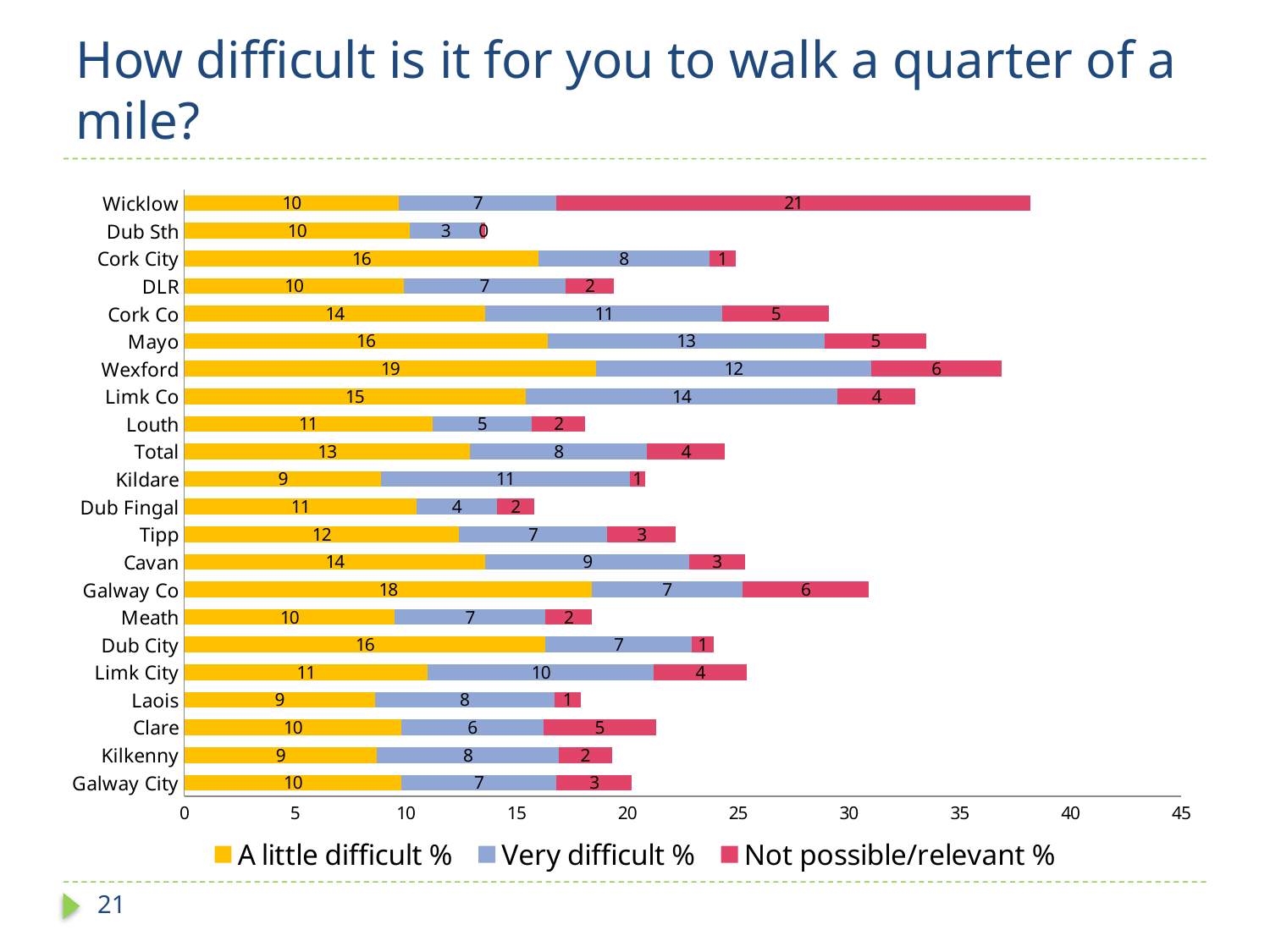
What is the total of the stacked bar for Wicklow? 38 What is the total of the stacked bar for Total? 25 How many categories are shown on the chart? 22 What is the 'Not possible/relevant %' value for Wicklow? 21 Which is larger, the 'A little difficult %' value for Galway Co or for Cork City? Galway Co Which category has the highest 'A little difficult %' value? Wexford What is the 'A little difficult %' value for Wexford? 19 What is the difference between the 'Very difficult %' values for Mayo and Louth? 8 What is the 'Very difficult %' value for Limk Co? 14 How many series does the legend list? 3 Which category has the highest 'Not possible/relevant %' value? Wicklow Which category has the lowest 'Not possible/relevant %' value? Dub Sth